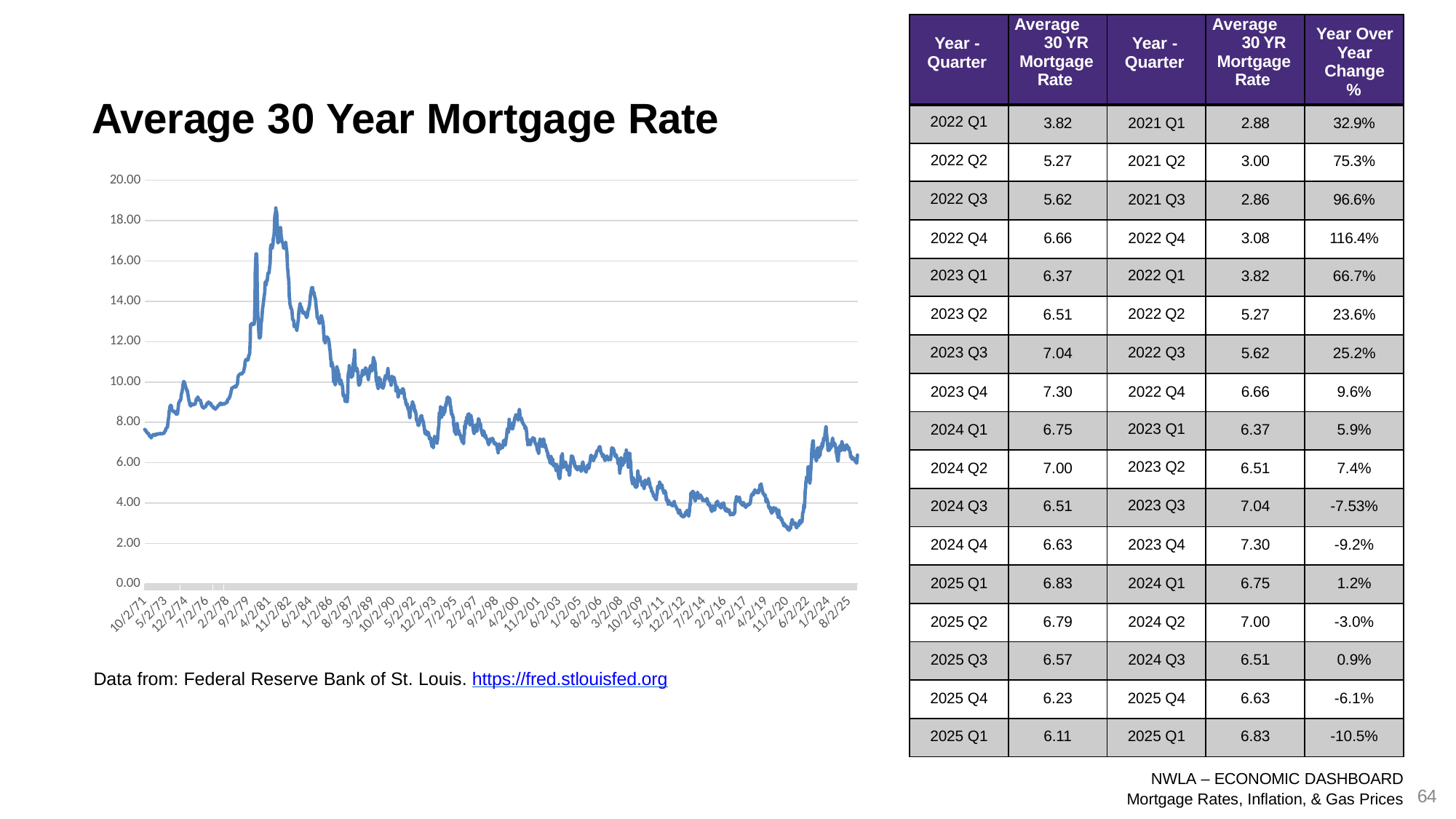
What is the title of the chart on the slide? Average 30 Year Mortgage Rate Is the value of the mortgage rate line at the end of the chart (8/2/25) greater or less than 8.00? less Is the peak value of the mortgage rate line, around 1981, greater or less than 18.00? greater Which is higher on the chart: the mortgage rate around 1981 or the mortgage rate around 2020? around 1981 Is the value of the mortgage rate line at the end of the chart (8/2/25) greater or less than 4.00? greater What kind of chart is shown on the slide? line chart Does the mortgage rate line generally rise or fall between its 1981 peak and 2012? fall How many lines (series) are plotted on the chart? 1 What is the highest value shown on the chart's vertical axis? 20.00 Does the mortgage rate line rise or fall between late 2020 and 2023? rise